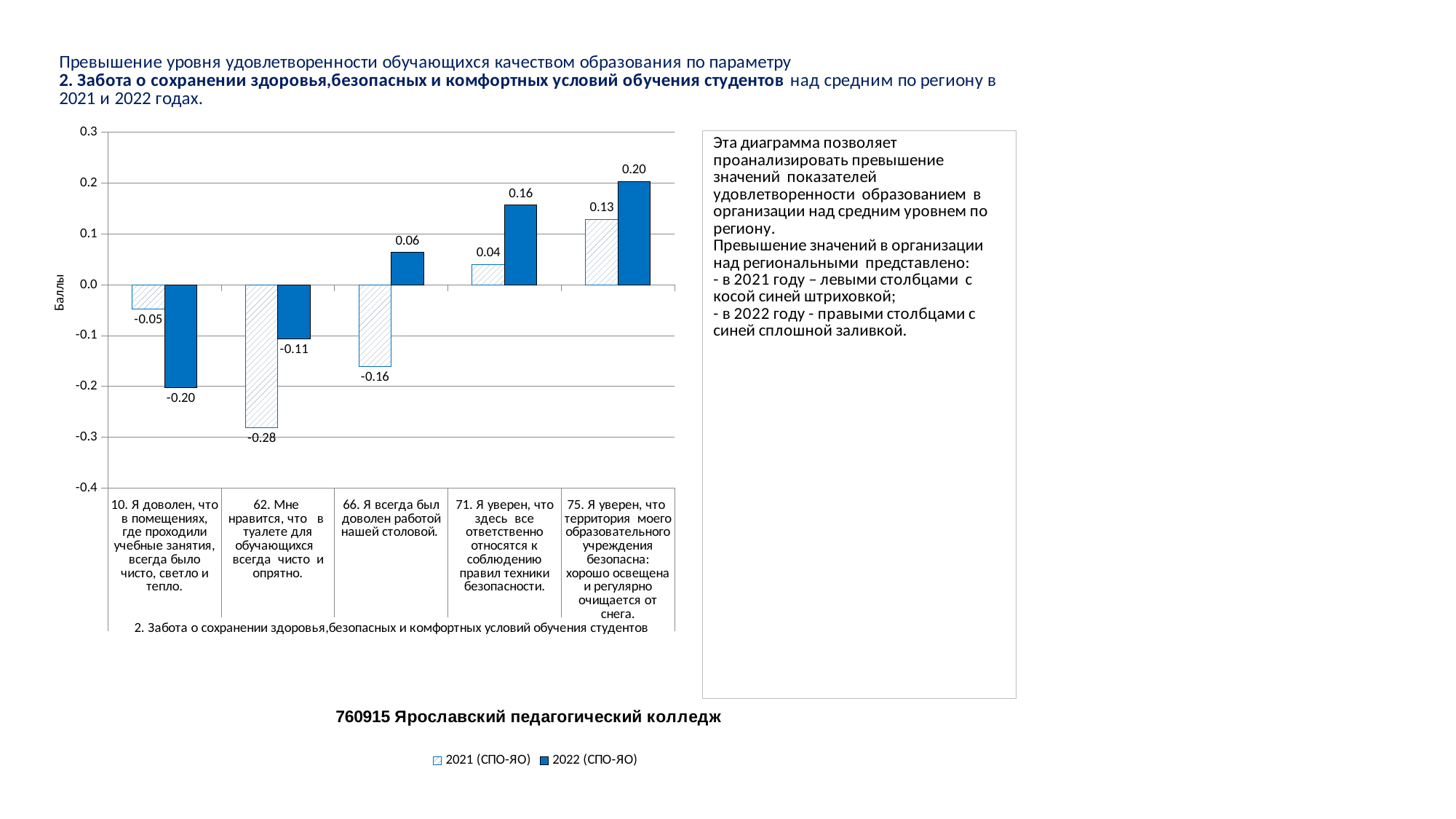
What is the 2021 (СПО-ЯО) value for item 62 (Мне нравится, что в туалете для обучающихся всегда чисто и опрятно)? -0.28 For item 10, which is larger: the 2021 value or the 2022 value? 2021 (СПО-ЯО) How many items (categories) are shown on the x axis of the chart? 5 What type of chart is shown on the slide? Bar chart What is the difference between the 2022 and 2021 values for item 66 (Я всегда был доволен работой нашей столовой)? 0.22 For item 71 (Я уверен, что здесь все ответственно относятся к соблюдению правил техники безопасности), which is larger: the 2021 value or the 2022 value? 2022 (СПО-ЯО) How many series does the legend list? 2 Which item has the highest 2022 (СПО-ЯО) value? 75. Я уверен, что территория моего образовательного учреждения безопасна What is the 2022 (СПО-ЯО) value for item 10 (Я доволен, что в помещениях, где проходили учебные занятия, всегда было чисто, светло и тепло)? -0.20 What is the 2022 (СПО-ЯО) value for item 75 (Я уверен, что территория моего образовательного учреждения безопасна)? 0.20 What is the label of the vertical axis of the chart? Баллы Which item has the lowest 2021 (СПО-ЯО) value? 62. Мне нравится, что в туалете для обучающихся всегда чисто и опрятно.